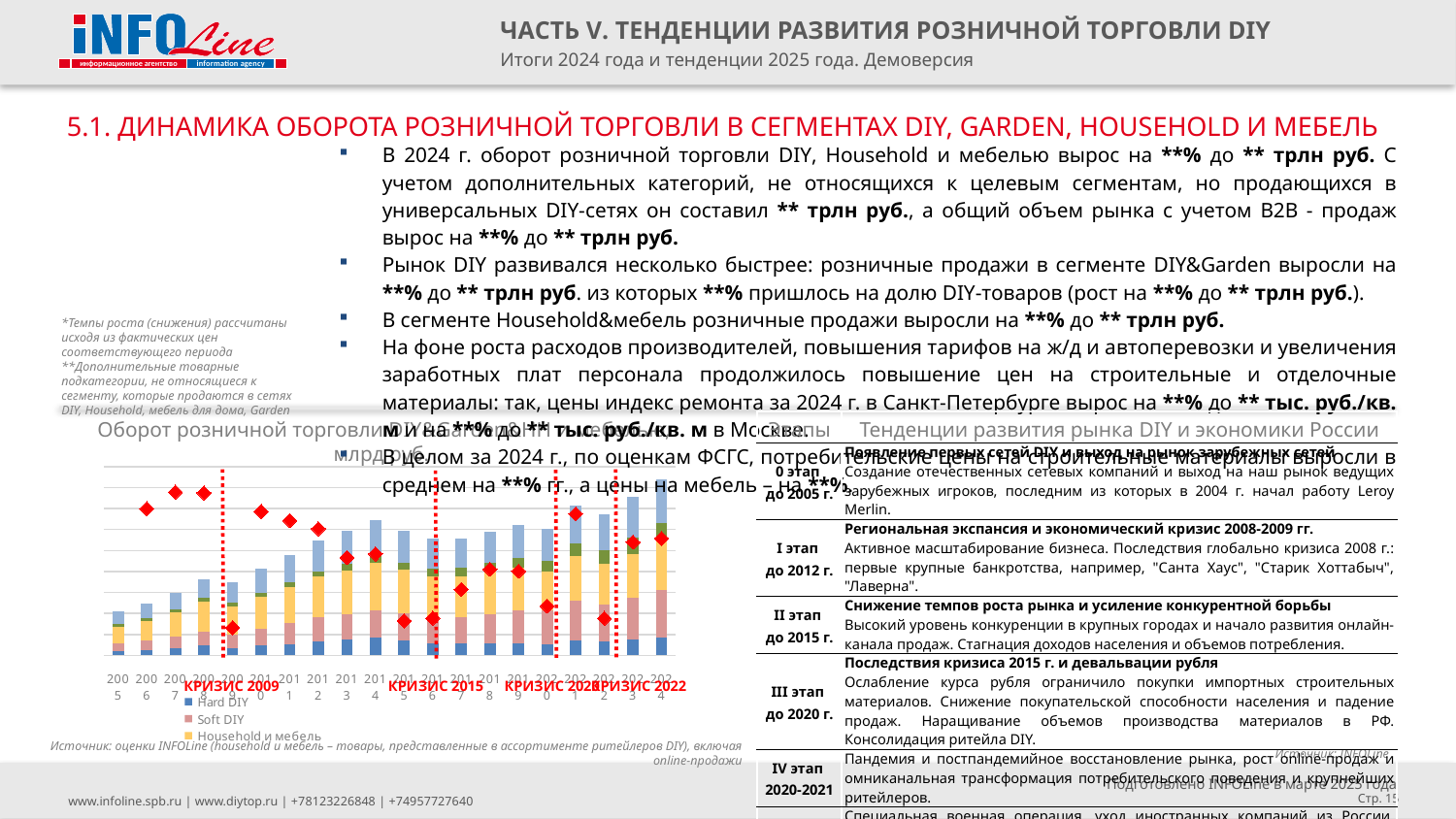
Do the stacked bars generally rise or fall from 2005 to 2024? Rise Is the stacked bar for 2024 taller or shorter than the stacked bar for 2005? Taller Which series in the chart is shown in blue? Hard DIY Is the stacked bar for 2021 taller or shorter than the stacked bar for 2009? Taller Which year has the shortest stacked bar in the chart? 2005 What kind of chart is shown on the slide? Combination chart: stacked bars with a line series (red diamond markers) Which year has the tallest stacked bar in the chart? 2024 Which series in the chart is shown in yellow? Household и мебель How many years (bars) are plotted along the x axis of the chart? 20